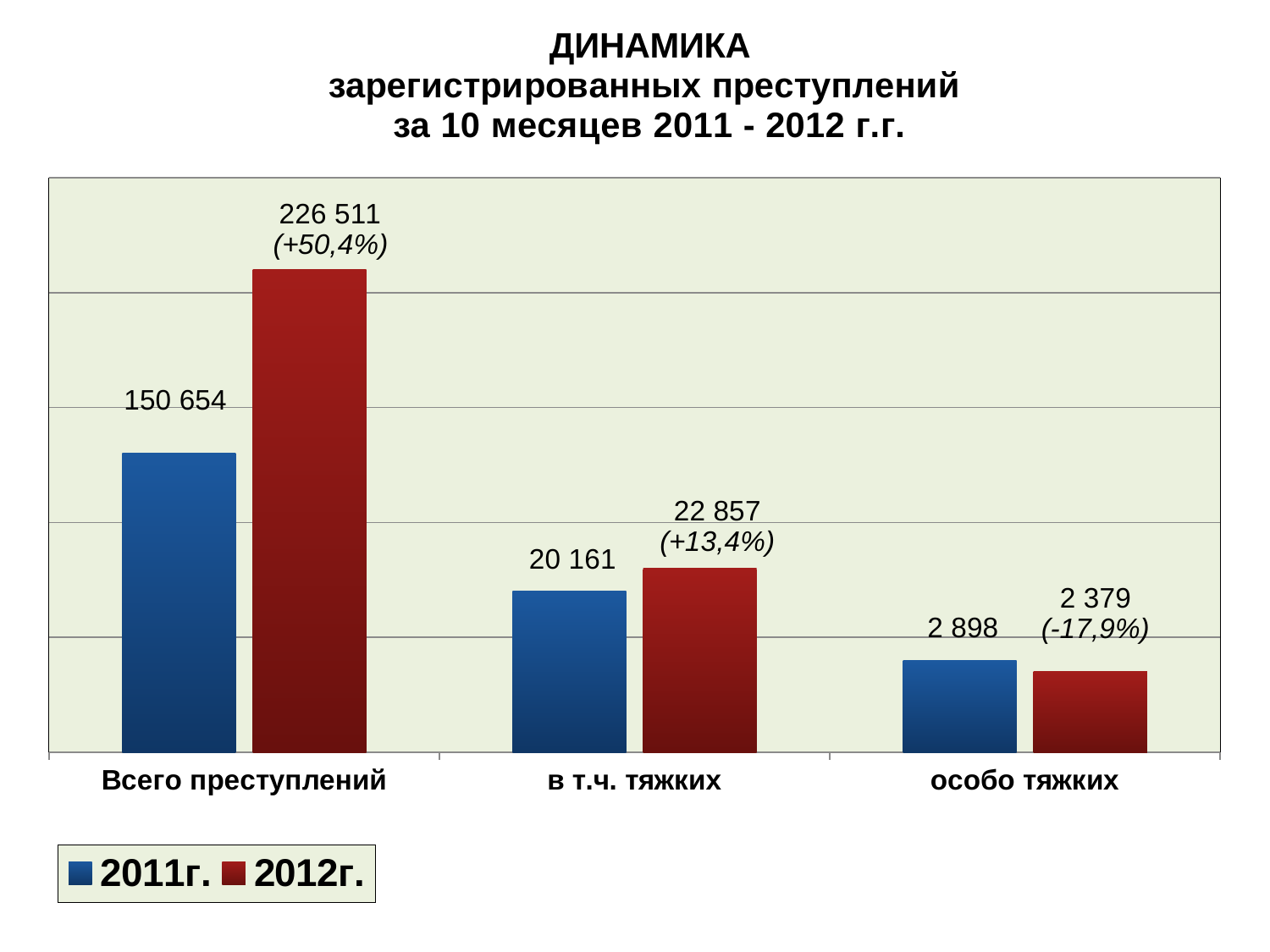
What is the value for 2011г. in the category Всего преступлений? 150 654 How many categories are shown on the x axis? 3 What is the difference between the 2012г. and 2011г. values for Всего преступлений? 75 857 What percentage change is shown next to the 2012г. bar for особо тяжких? -17,9% How many series does the legend list? 2 In the category особо тяжких, which is larger: the 2011г. value or the 2012г. value? 2011г. What is the difference between the 2011г. and 2012г. values for особо тяжких? 519 What is the value for 2012г. in the category Всего преступлений? 226 511 What is the value for 2011г. in the category особо тяжких? 2 898 Which category has the highest value for 2012г.? Всего преступлений What is the value for 2012г. in the category в т.ч. тяжких? 22 857 Which category has the lowest value for 2011г.? особо тяжких